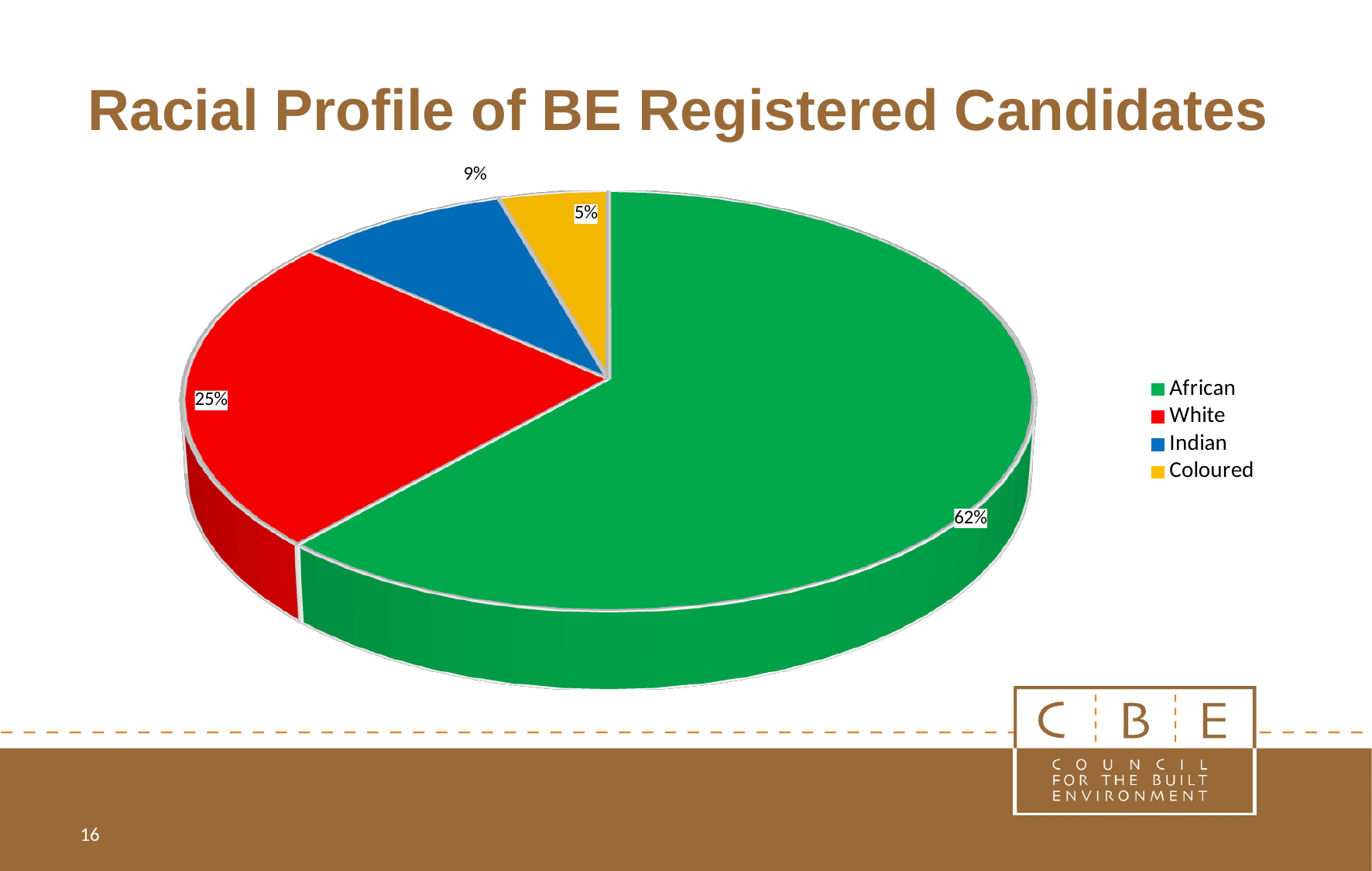
What percentage of BE registered candidates are Indian? 9% What is the difference in percentage points between the African and White shares? 37 Which racial group has the smallest share of BE registered candidates? Coloured What is the title of the chart? Racial Profile of BE Registered Candidates What percentage of BE registered candidates are White? 25% What percentage of BE registered candidates are Coloured? 5% How many racial groups are shown in the pie chart? 4 Which racial group has the largest share of BE registered candidates? African Which group has a larger share, Indian or Coloured? Indian What percentage of BE registered candidates are African? 62% What type of chart is shown on the slide? Pie chart Which colour represents the White group in the chart? Red